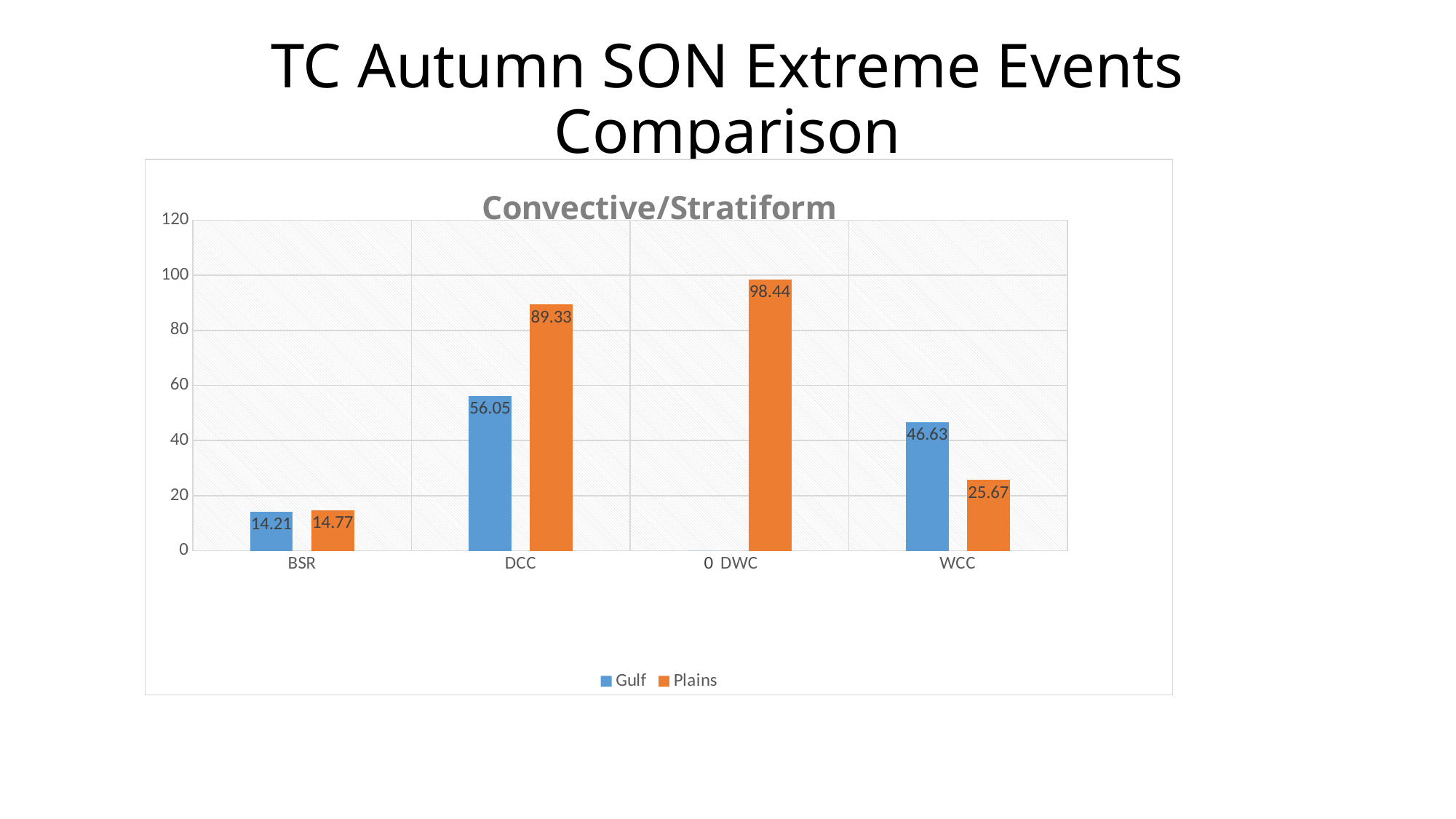
What is the Plains value for DWC? 98.44 What kind of chart is shown? Bar chart How many series does the legend list? 2 How many categories are shown on the x axis? 4 For WCC, which series has the larger value, Gulf or Plains? Gulf What is the Gulf value for WCC? 46.63 What is the title of the chart? Convective/Stratiform Which category has the lowest Plains value? BSR What is the difference between the Plains and Gulf values for DCC? 33.28 What is the Gulf value for BSR? 14.21 Which category has the highest Plains value? DWC What is the Plains value for DCC? 89.33